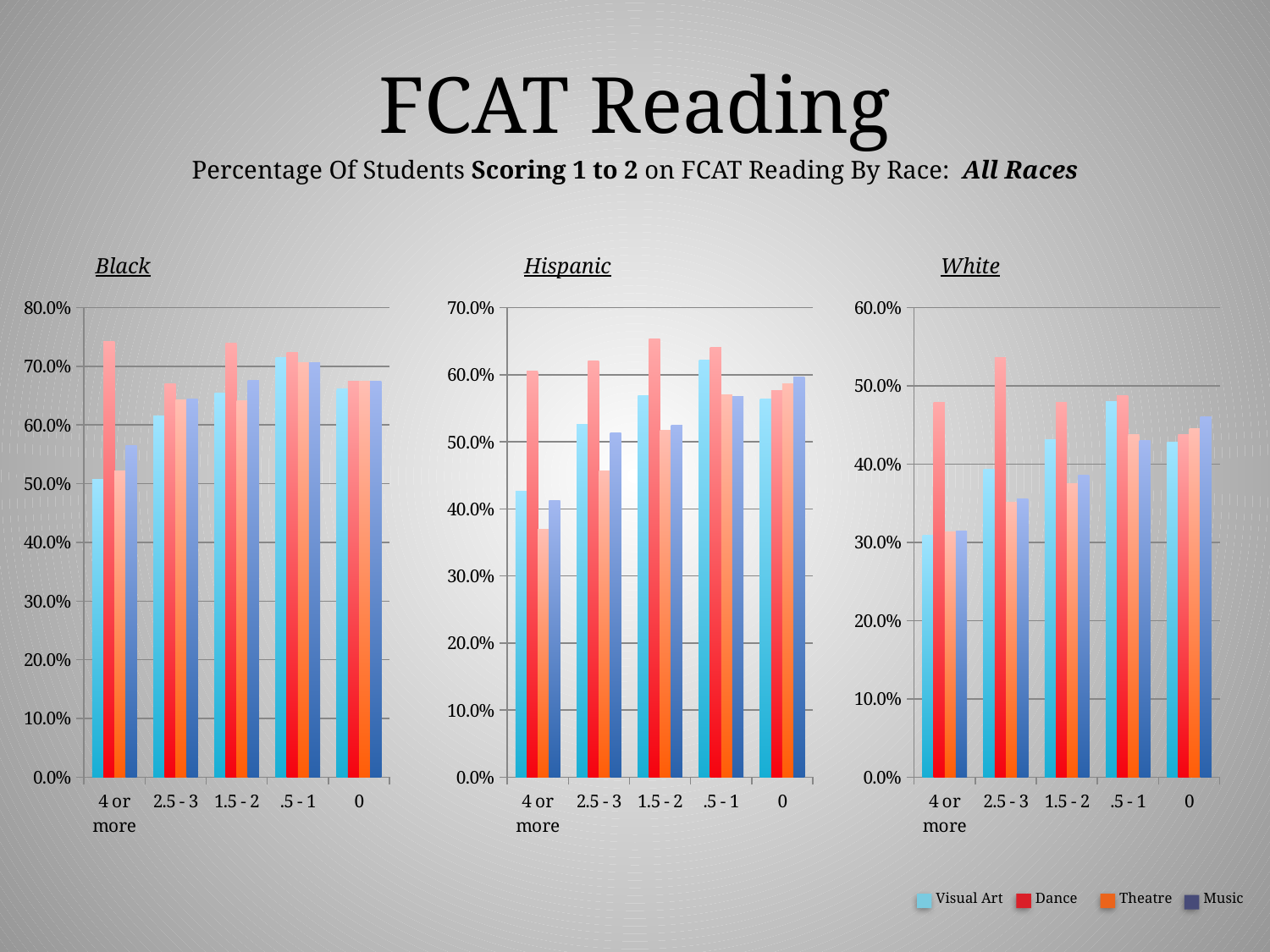
In the White chart, is the value for Visual Art at '4 or more' greater or less than 40.0%? less What kind of chart is the Black chart? bar chart How many series does the legend list? 4 In the Black chart, which is larger at '4 or more': Dance or Visual Art? Dance In the Hispanic chart, which series has the lowest value at '4 or more'? Theatre How many categories are shown on the x axis of the Hispanic chart? 5 In the White chart, is the value for Dance at '2.5 - 3' greater or less than 50.0%? greater In the White chart, which is larger at '2.5 - 3': Dance or Theatre? Dance In the Hispanic chart, does the Visual Art value rise or fall from '4 or more' to '.5 - 1'? rise In the Hispanic chart, which series has the highest value at '4 or more'? Dance In the Black chart, is the value for Dance at '4 or more' greater or less than 70.0%? greater